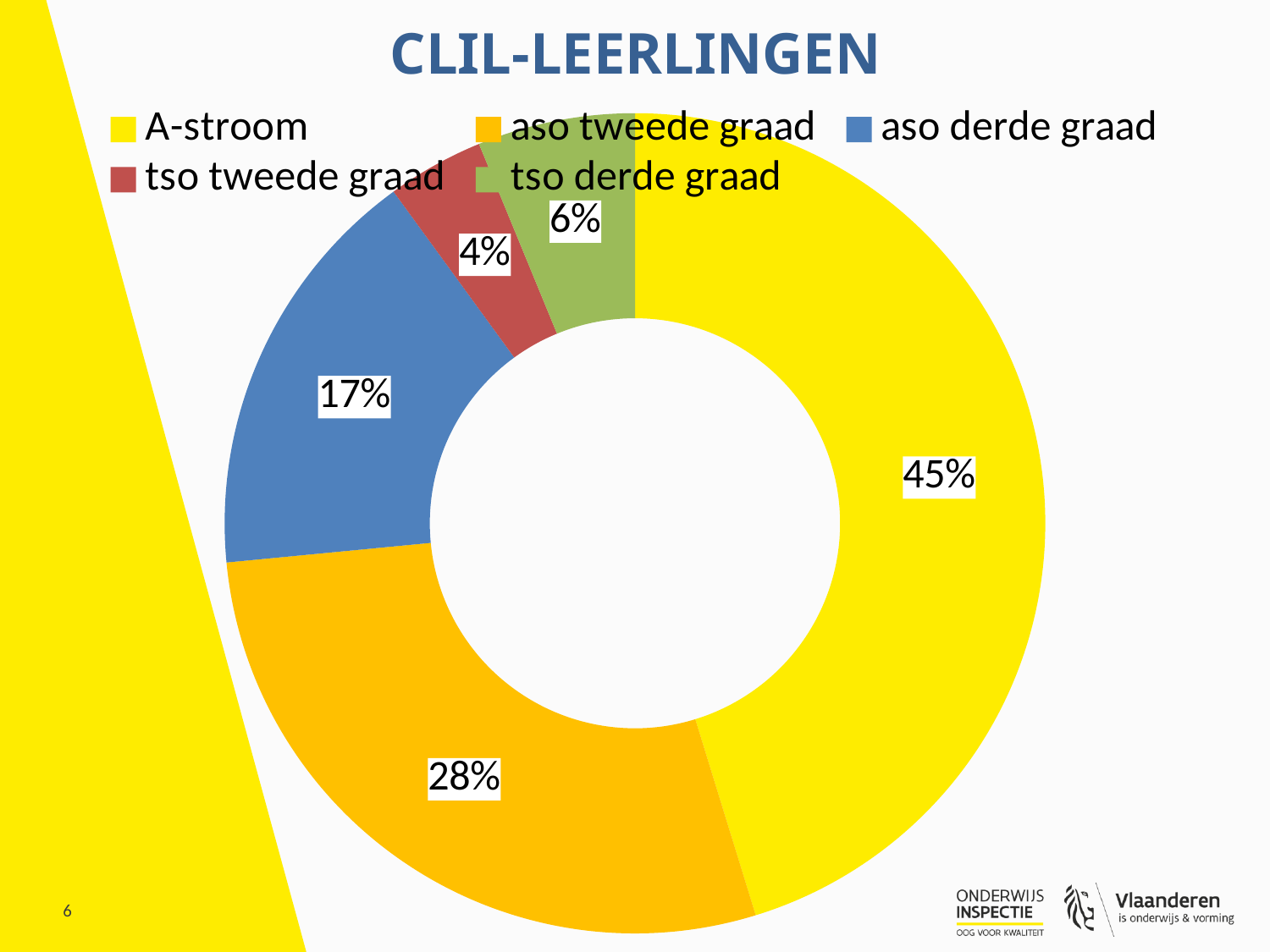
How many categories are shown in the chart? 5 Which is larger, the share of aso derde graad or the share of tso derde graad? aso derde graad Which category has the smallest share of the chart? tso tweede graad What share of the doughnut chart does A-stroom represent? 45% What is the title of the chart? CLIL-LEERLINGEN What is the difference between the shares of A-stroom and aso tweede graad? 17% What is the value for aso derde graad? 17% What is the value for tso derde graad? 6% What kind of chart is shown on the slide? doughnut chart What is the value for aso tweede graad? 28% Which category has the largest share of the chart? A-stroom What is the value for tso tweede graad? 4%